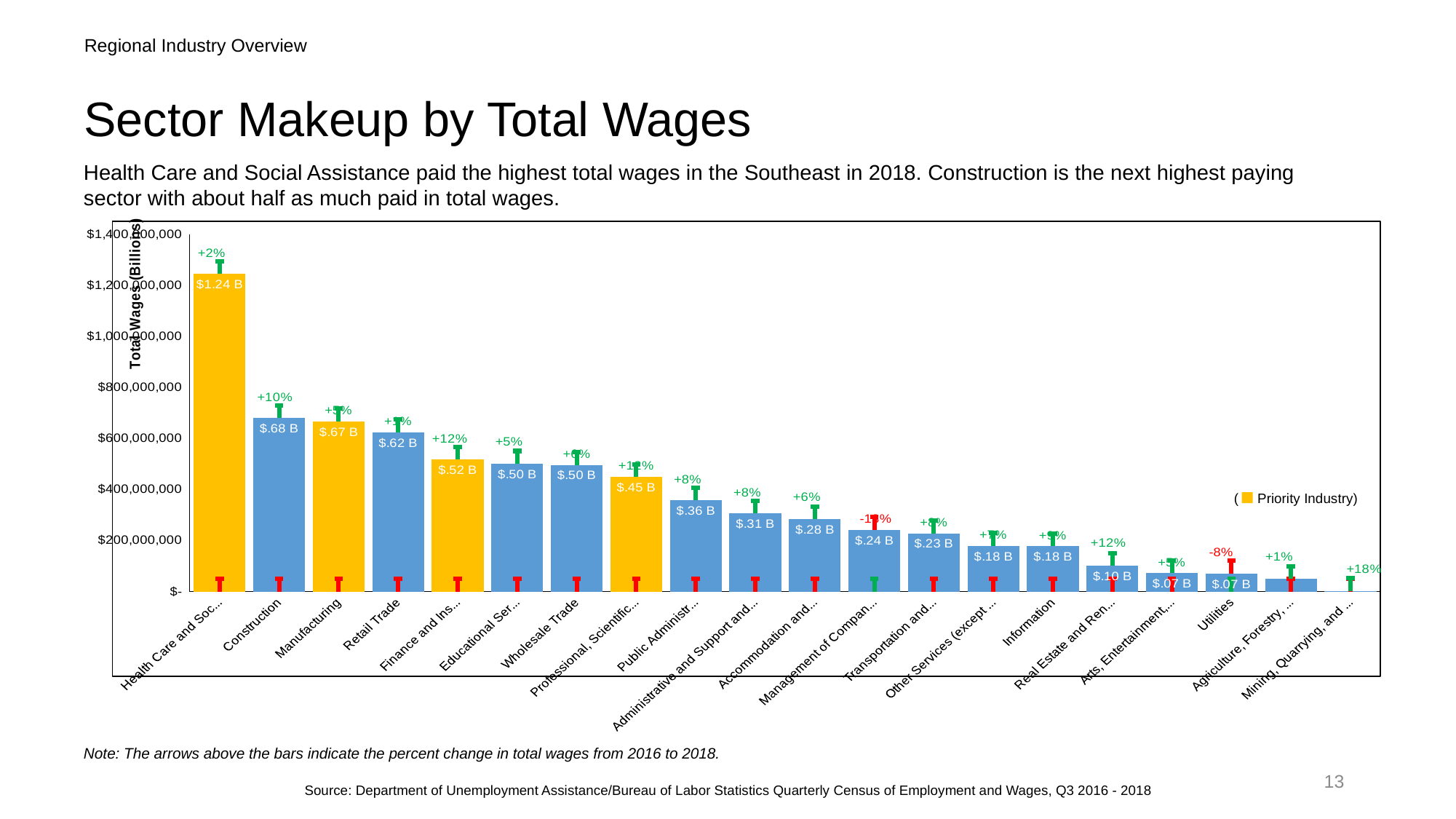
Which has higher total wages, Manufacturing or Retail Trade? Manufacturing What percent change in total wages is shown above the Utilities bar? -8% What is the total wages value shown for Construction? $.68 B What kind of chart is shown on the slide? bar chart What is the difference in total wages between Health Care and Social Assistance and Construction? $.56 B Do the total wages values rise or fall moving from left to right along the x axis? fall What is the total wages value shown for Retail Trade? $.62 B How many sectors are shown on the x axis of the chart? 20 What percent change in total wages is shown above the Construction bar? +10% Is the total wages value for Agriculture, Forestry greater or less than $200,000,000? less Which sector has the highest total wages? Health Care and Social Assistance What is the total wages value shown for Public Administration? $.36 B